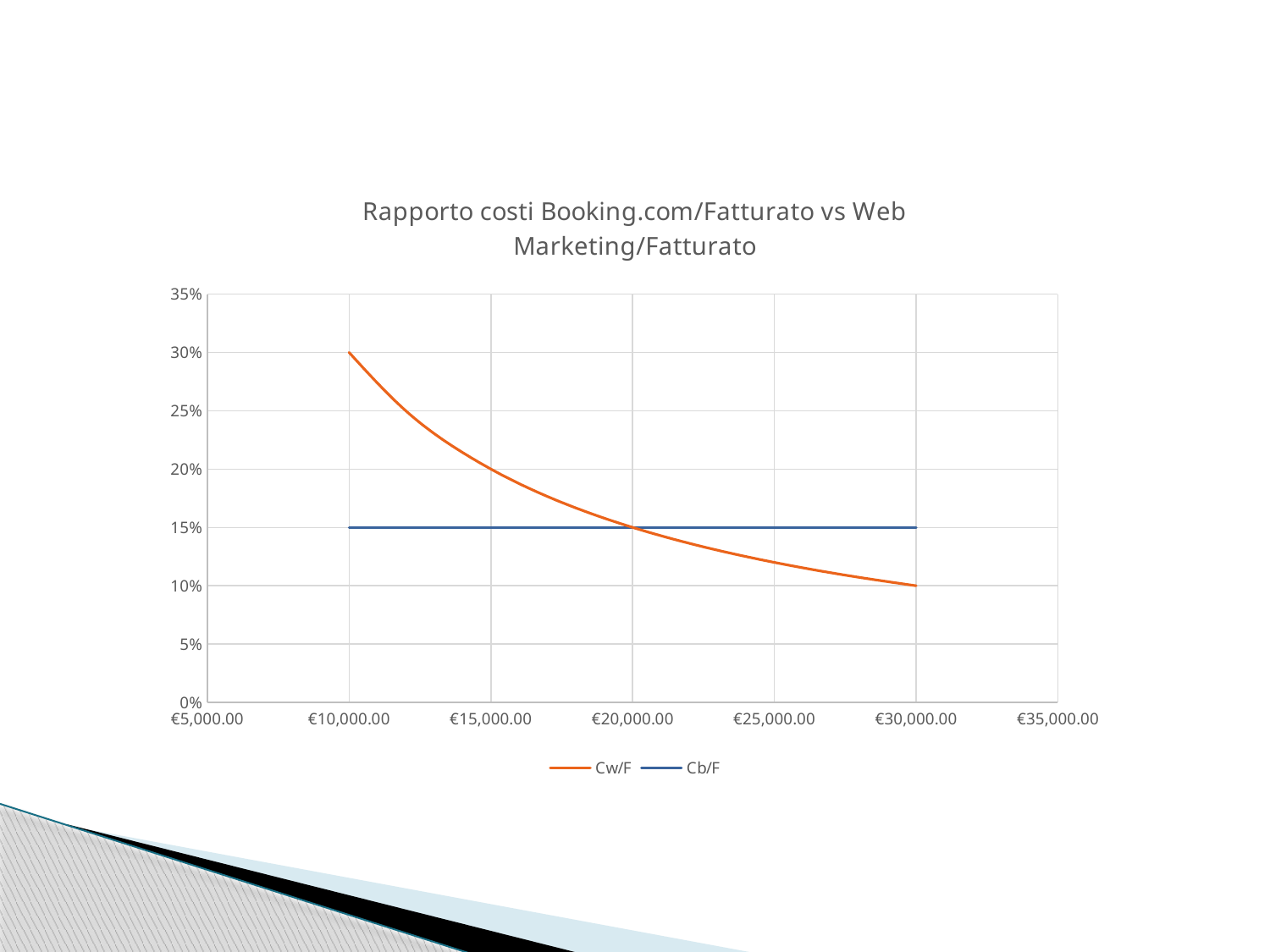
What is the title of the chart? Rapporto costi Booking.com/Fatturato vs Web Marketing/Fatturato What is the value of Cb/F at €20,000.00? 15% How many series does the legend list? 2 Which series has the higher value at €10,000.00, Cw/F or Cb/F? Cw/F Does the Cb/F series rise, fall or stay flat along the x axis? stay flat Does the Cw/F series rise or fall as the x-axis value increases? fall What kind of chart is shown on the slide? line chart What is the value of Cw/F at €30,000.00? 10% What is the value of Cw/F at €10,000.00? 30% Which series is drawn in orange? Cw/F Which series has the higher value at €30,000.00, Cw/F or Cb/F? Cb/F Is the value of Cw/F at €25,000.00 greater or less than 15%? less